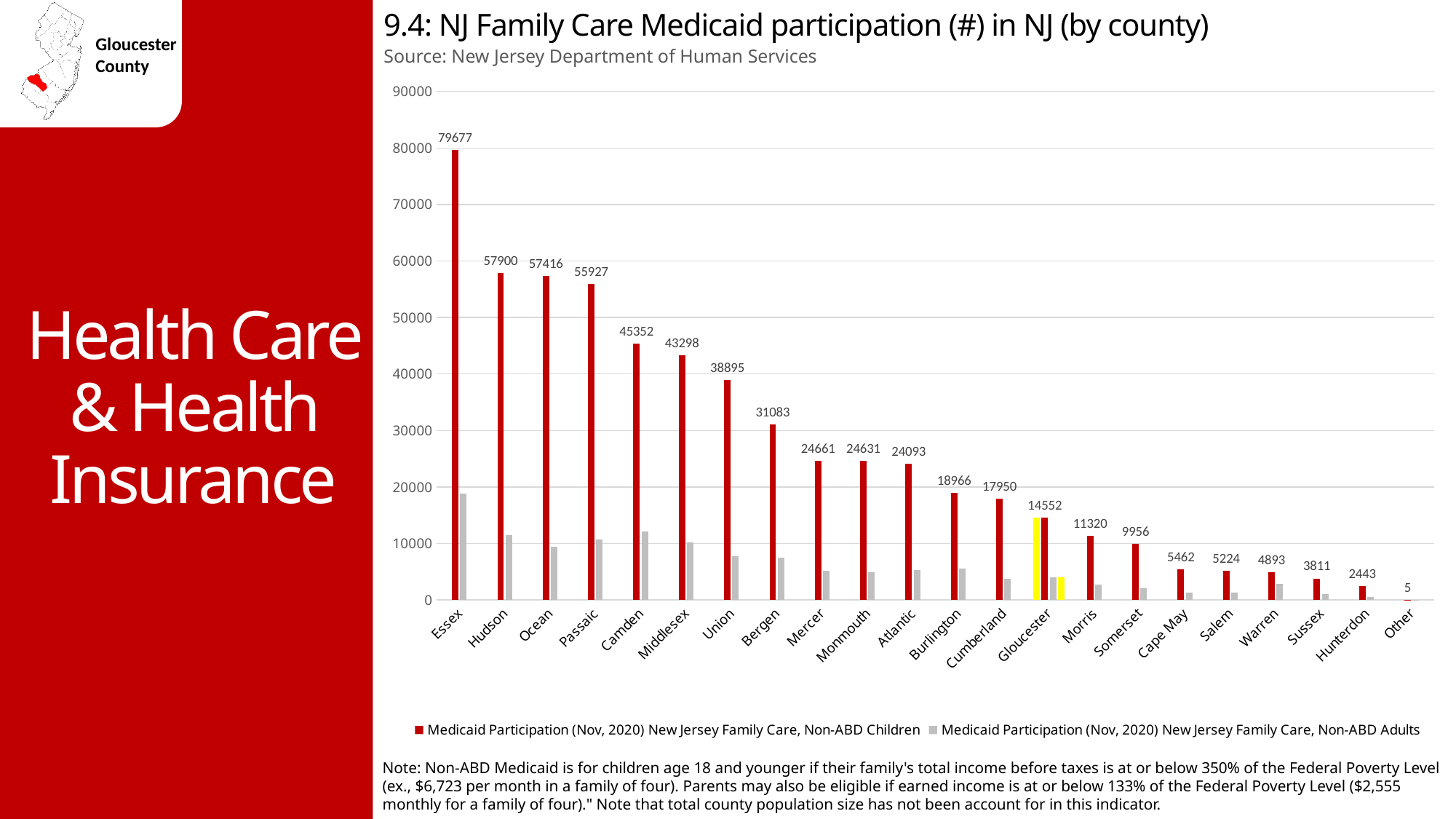
Which county has the highest Non-ABD Children Medicaid participation? Essex How many categories are shown on the x axis? 22 What kind of chart is shown on the slide? bar chart Which has a larger Non-ABD Children value, Bergen or Mercer? Bergen Which category has the lowest Non-ABD Children Medicaid participation? Other What is the Non-ABD Children Medicaid participation value for Gloucester? 14552 What is the Non-ABD Children Medicaid participation value for Camden? 45352 How many series does the legend list? 2 What is the Non-ABD Children Medicaid participation value for Essex? 79677 Which county's bars are highlighted in yellow? Gloucester Is the Non-ABD Adults value for Essex greater or less than 10000? greater What is the difference between the Non-ABD Children values for Hudson and Ocean? 484